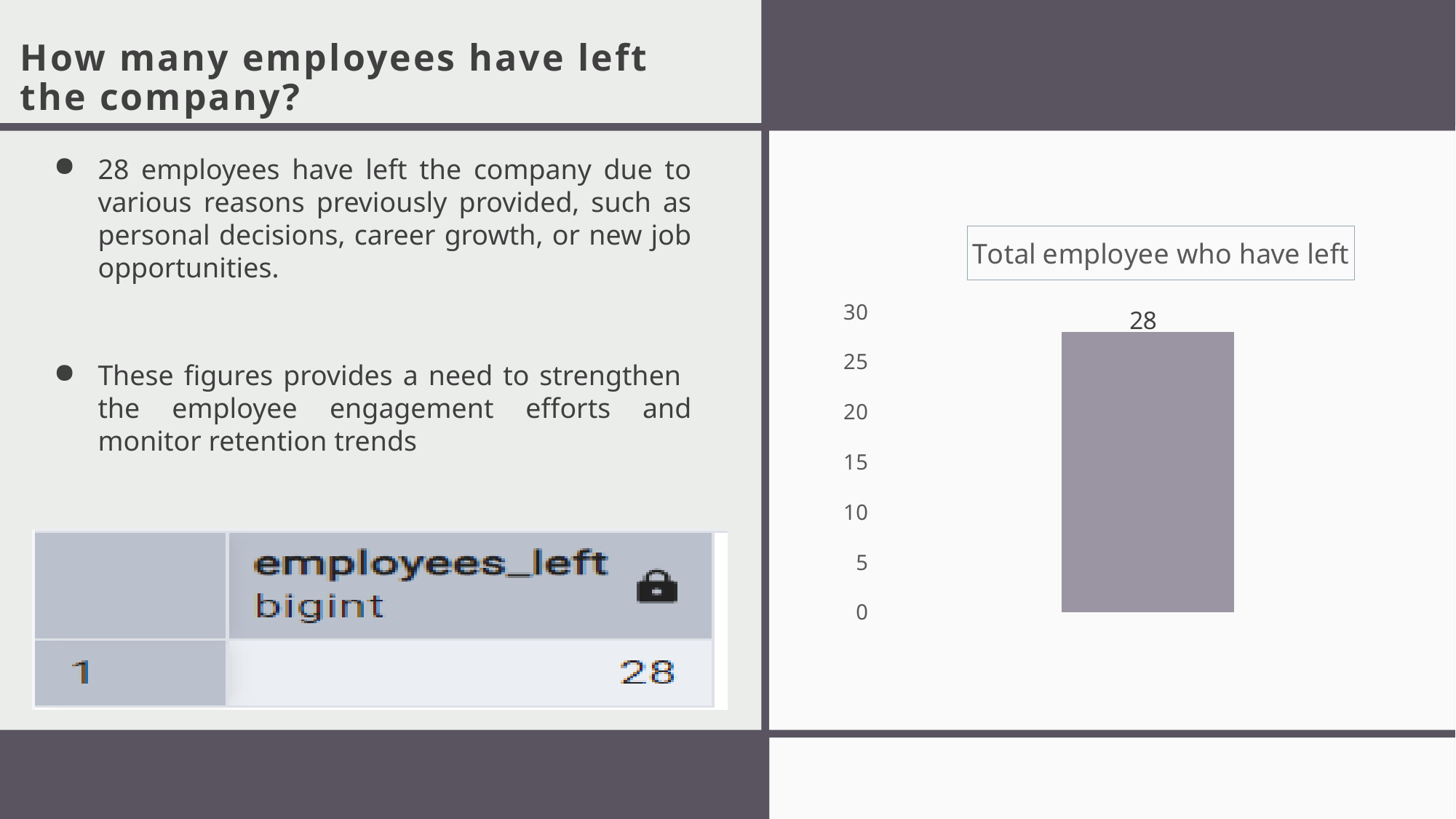
Is the value of the bar in the chart greater or less than 25? greater Is the value of the bar in the chart greater or less than 30? less What is the value shown on the bar in the chart titled "Total employee who have left"? 28 How many bars are plotted in the chart? 1 What kind of chart is shown on the slide? bar chart What is the highest value shown on the vertical axis of the chart? 30 What is the title of the chart on the slide? Total employee who have left